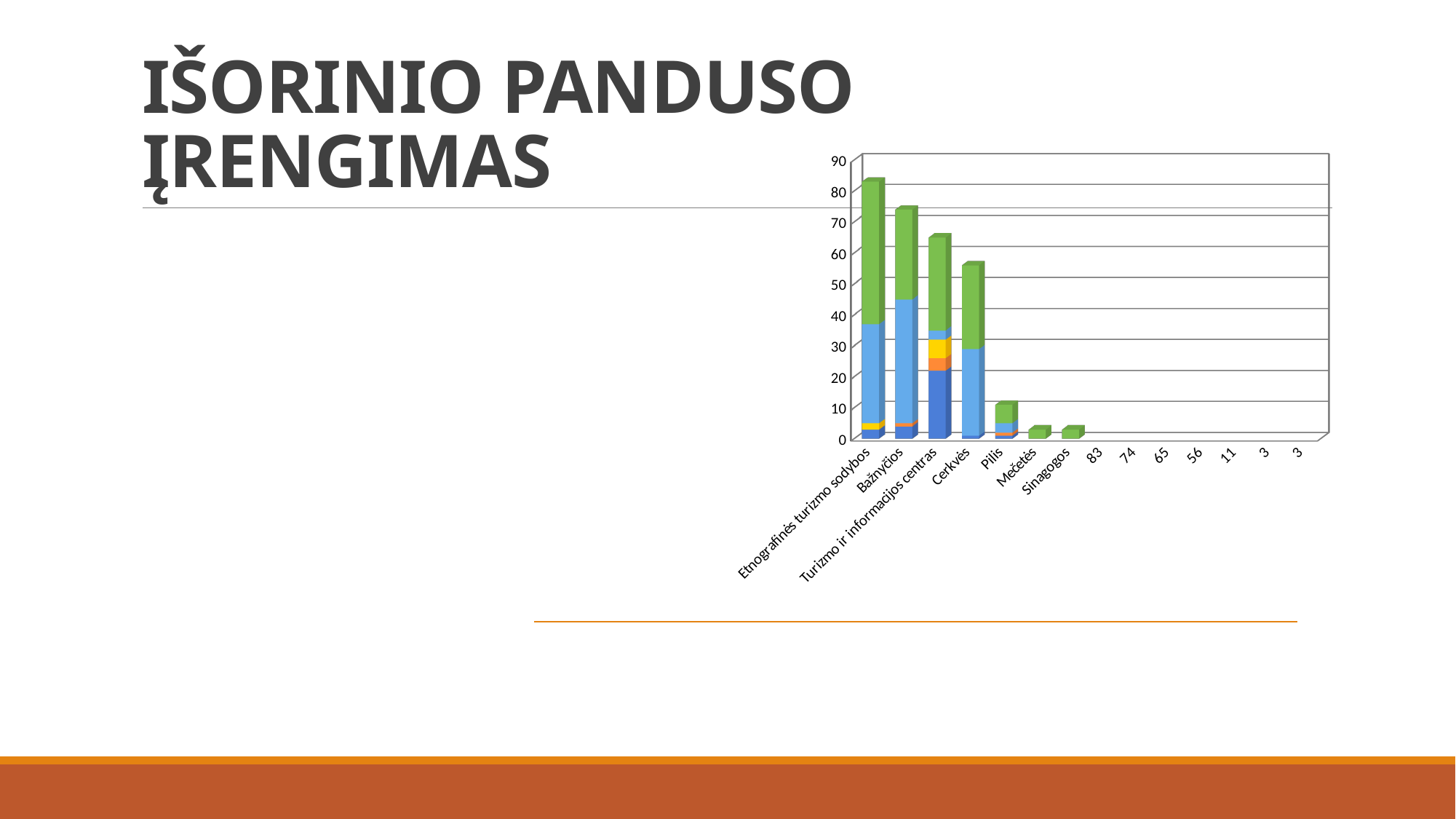
Is the total value for Bažnyčios greater or less than 70? greater Is the total value for Etnografinės turizmo sodybos greater or less than 80? greater Which category has the tallest bar? Etnografinės turizmo sodybos How many categories have a visible bar in the chart? 7 Is the total value for Mečetės greater or less than 10? less What kind of chart is shown on the slide? bar chart Which has a taller bar, Bažnyčios or Cerkvės? Bažnyčios What colour is the topmost segment of each stacked bar? green Do the bar heights rise or fall from left to right along the x axis? fall